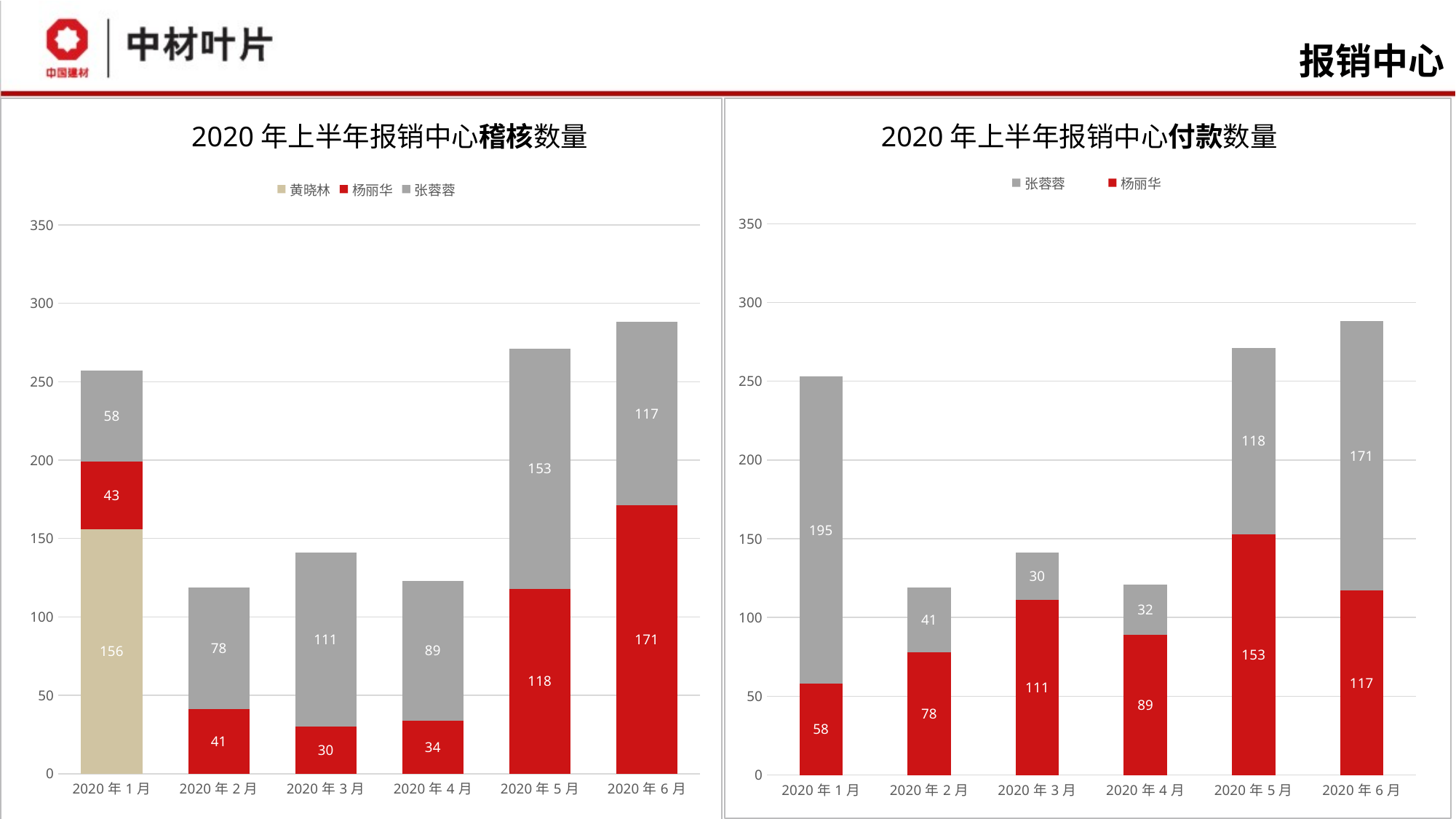
In the right chart (2020年上半年报销中心付款数量), what is the value for 杨丽华 in 2020年4月? 89 In the left chart (2020年上半年报销中心稽核数量), what is the value for 张蓉蓉 in 2020年5月? 153 In the left chart (2020年上半年报销中心稽核数量), what is the total of the stacked bar for 2020年1月? 257 In the right chart (2020年上半年报销中心付款数量), what is the difference between 杨丽华's value in 2020年5月 and 2020年6月? 36 In the right chart (2020年上半年报销中心付款数量), which month has the lowest total stacked bar? 2020年2月 In the right chart (2020年上半年报销中心付款数量), is the value for 张蓉蓉 in 2020年3月 larger or smaller than the value for 杨丽华 in the same month? smaller In the left chart (2020年上半年报销中心稽核数量), what is the value for 杨丽华 in 2020年1月? 43 In the right chart (2020年上半年报销中心付款数量), what is the value for 张蓉蓉 in 2020年1月? 195 What kind of chart is the left chart (2020年上半年报销中心稽核数量)? stacked bar chart In the right chart (2020年上半年报销中心付款数量), what is the total of the stacked bar for 2020年6月? 288 In the left chart (2020年上半年报销中心稽核数量), how many series does the legend list? 3 In the left chart (2020年上半年报销中心稽核数量), which month has the highest total stacked bar? 2020年6月